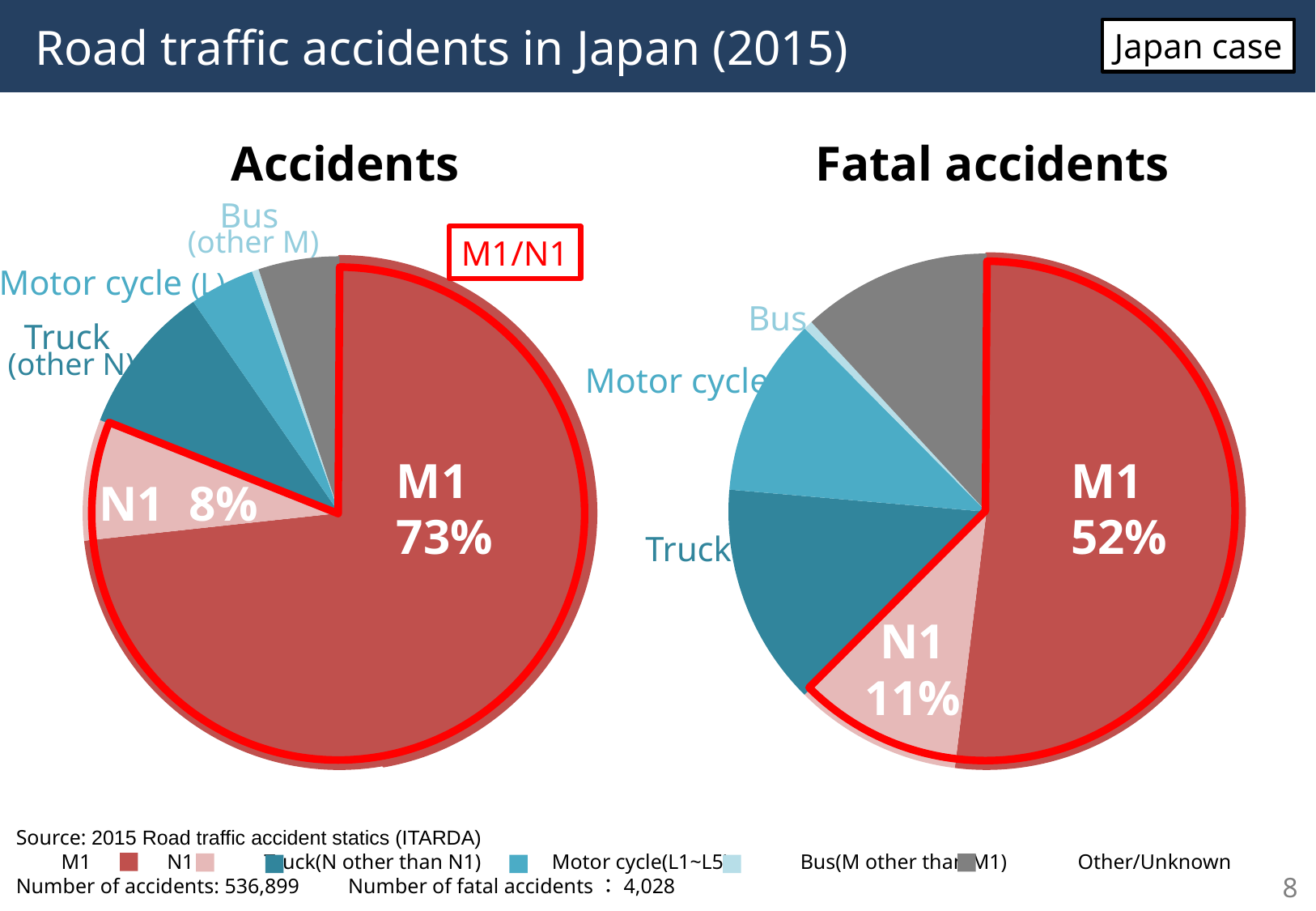
What type of chart is used for the Accidents and Fatal accidents data? Pie chart In the Fatal accidents pie chart, what share is labelled for N1? 11% What is the title of the chart on the right side of the slide? Fatal accidents In the Fatal accidents pie chart, what share is labelled for M1? 52% What is the difference between the M1 share in the Accidents chart and the M1 share in the Fatal accidents chart? 21 percentage points In the Accidents pie chart, what share is labelled for N1? 8% Is the N1 share larger in the Accidents chart or in the Fatal accidents chart? Fatal accidents In the Fatal accidents pie chart, which category has the largest slice? M1 What is the difference between the N1 share in the Fatal accidents chart and the N1 share in the Accidents chart? 3 percentage points In the Accidents pie chart, what share is labelled for M1? 73% How many categories does the legend at the bottom of the slide list? 6 In the Accidents pie chart, which category has the largest slice? M1